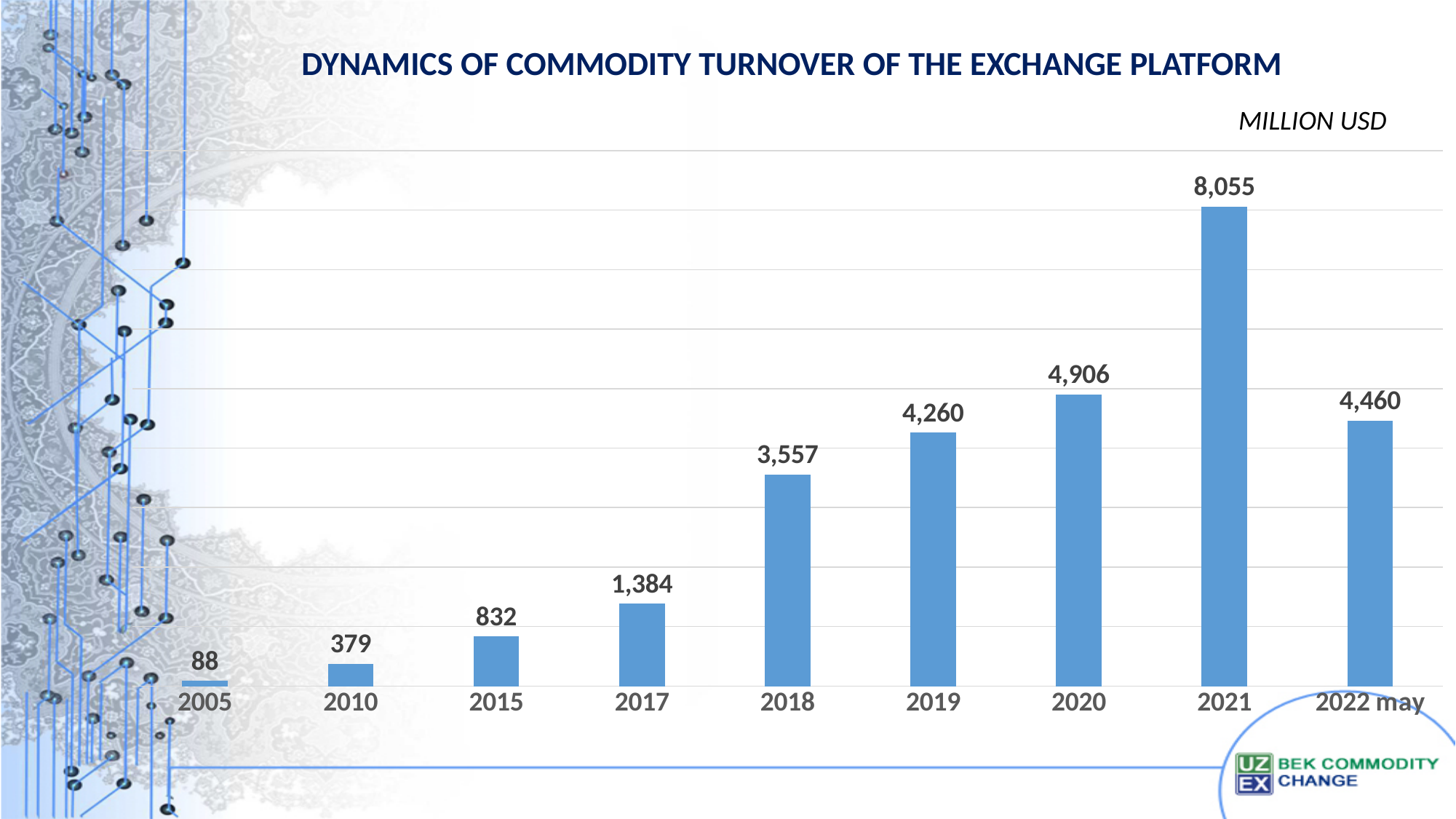
What is the difference between the values for 2019 and 2018? 703 Do the values rise or fall from 2005 to 2021? Rise Which is larger, the value for 2020 or the value for 2022 may? 2020 What unit is the chart measured in, according to the label above the chart? MILLION USD What is the commodity turnover value for 2018? 3,557 What is the commodity turnover value for 2021? 8,055 What is the difference between the values for 2021 and 2020? 3,149 What is the value shown for 2022 may? 4,460 What kind of chart is shown on the slide? Bar chart How many categories are shown on the x axis? 9 Which year has the highest commodity turnover? 2021 Which category has the lowest commodity turnover? 2005